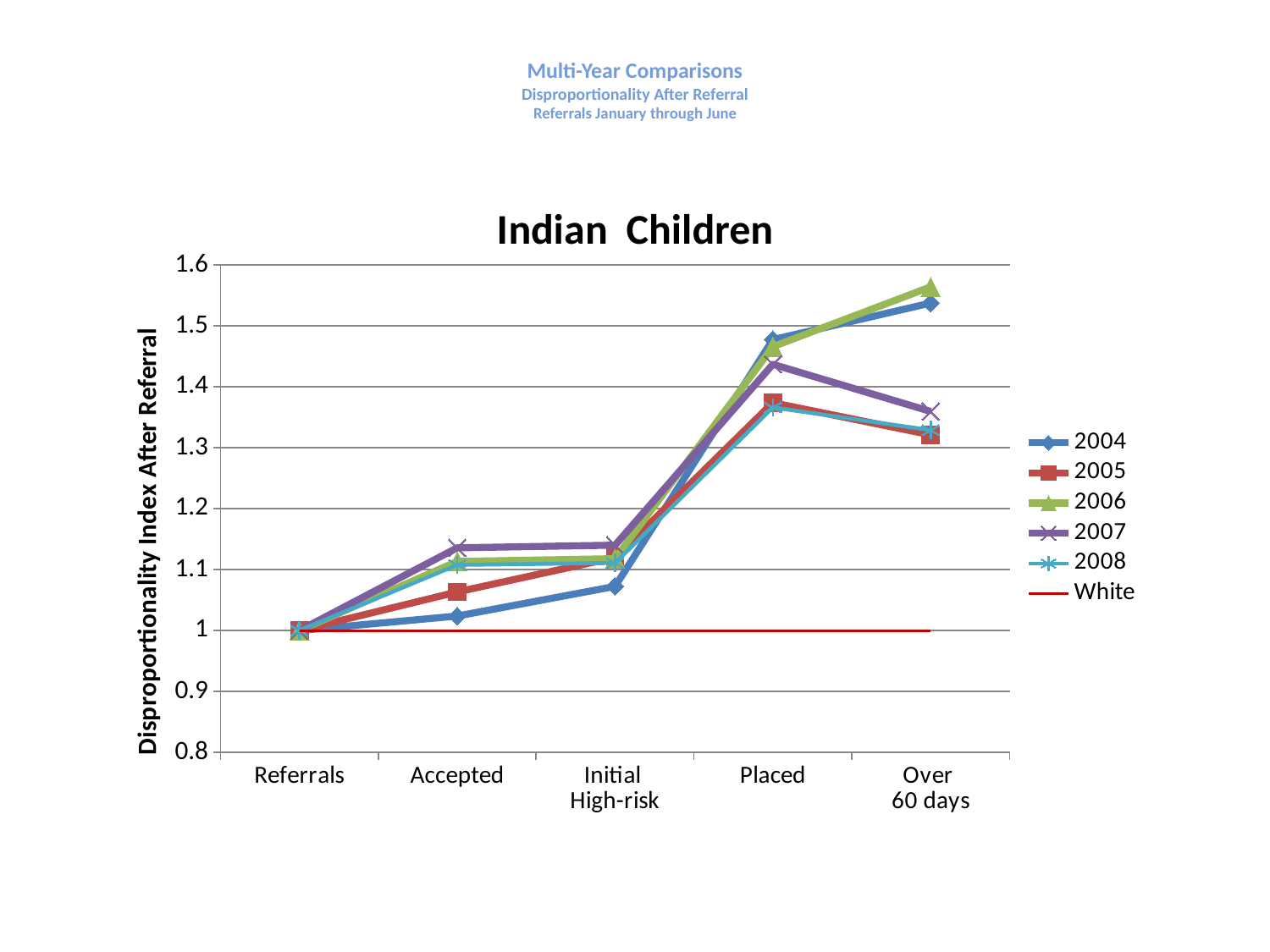
Is the value for 2006 at Over 60 days greater or less than 1.5? greater Does the 2007 series rise or fall from Placed to Over 60 days? fall What is the value of the White series across all categories? 1 What kind of chart is shown on the slide? line chart At Over 60 days, which is larger: the value for 2007 or the value for 2005? 2007 Is the value for 2004 at Placed greater or less than 1.4? greater Is the value for 2005 at Over 60 days greater or less than 1.4? less What is the title of the vertical axis? Disproportionality Index After Referral How many categories are shown along the x axis of the Indian Children chart? 5 Which year series has the lowest value at Accepted? 2004 How many series does the legend of the Indian Children chart list? 6